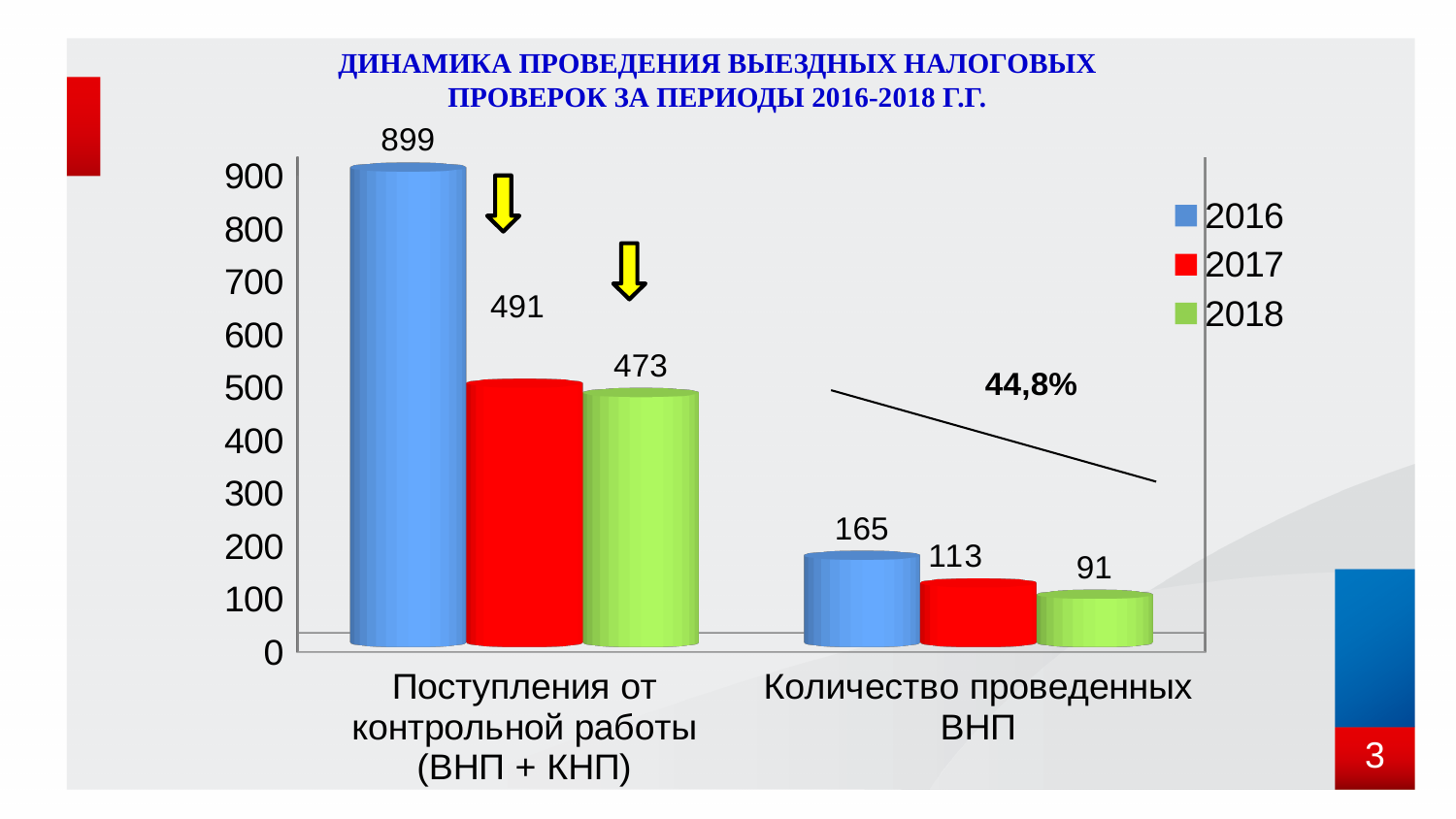
Which is larger: the 2017 value or the 2018 value in the category "Поступления от контрольной работы (ВНП + КНП)"? 2017 Which year has the highest value in the category "Поступления от контрольной работы (ВНП + КНП)"? 2016 How many series does the legend list? 3 What is the value for 2016 in the category "Поступления от контрольной работы (ВНП + КНП)"? 899 What kind of chart is shown on the slide? bar chart What is the difference between the 2016 and 2018 values in the category "Количество проведенных ВНП"? 74 Do the values in the category "Количество проведенных ВНП" rise or fall from 2016 to 2018? fall What is the difference between the 2016 and 2017 values in the category "Поступления от контрольной работы (ВНП + КНП)"? 408 What is the value for 2017 in the category "Количество проведенных ВНП"? 113 How many categories are shown on the x axis? 2 What is the value for 2018 in the category "Количество проведенных ВНП"? 91 Which year has the lowest value in the category "Количество проведенных ВНП"? 2018